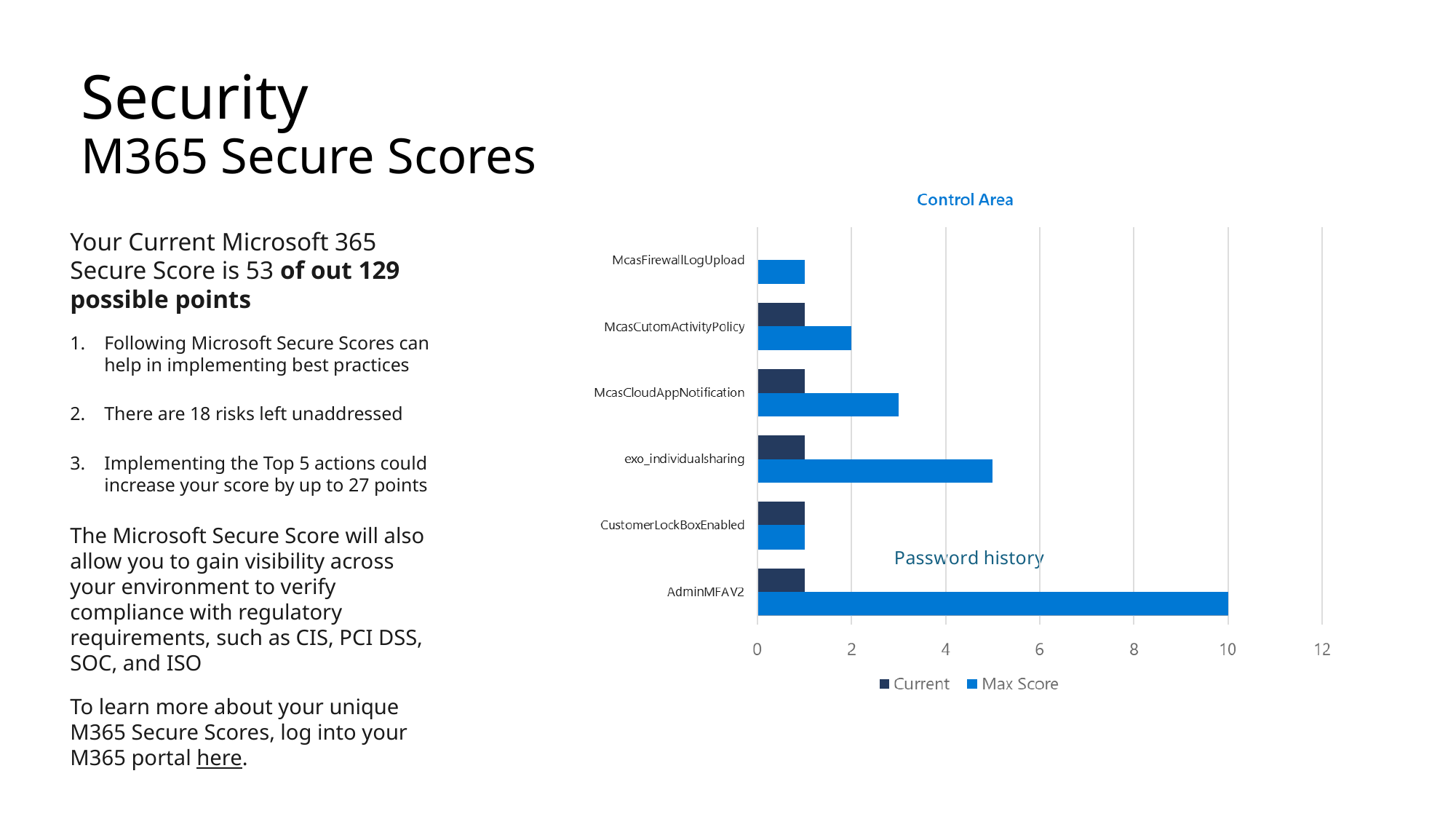
What are the two series named in the chart legend? Current and Max Score Which control area has the highest Max Score? AdminMFAV2 Which has the larger Max Score, exo_individualsharing or McasCloudAppNotification? exo_individualsharing What is the difference between the Max Score for AdminMFAV2 and the Max Score for McasCutomActivityPolicy? 8 What type of chart is shown on the slide? Bar chart Is the Current value for AdminMFAV2 greater or less than 2? less What is the title of the chart? Password history What is the Max Score value for AdminMFAV2? 10 What is the Max Score value for McasCutomActivityPolicy? 2 How many control areas (categories) are plotted on the chart? 6 Is the Max Score for exo_individualsharing greater or less than 4? greater How many series does the chart legend list? 2